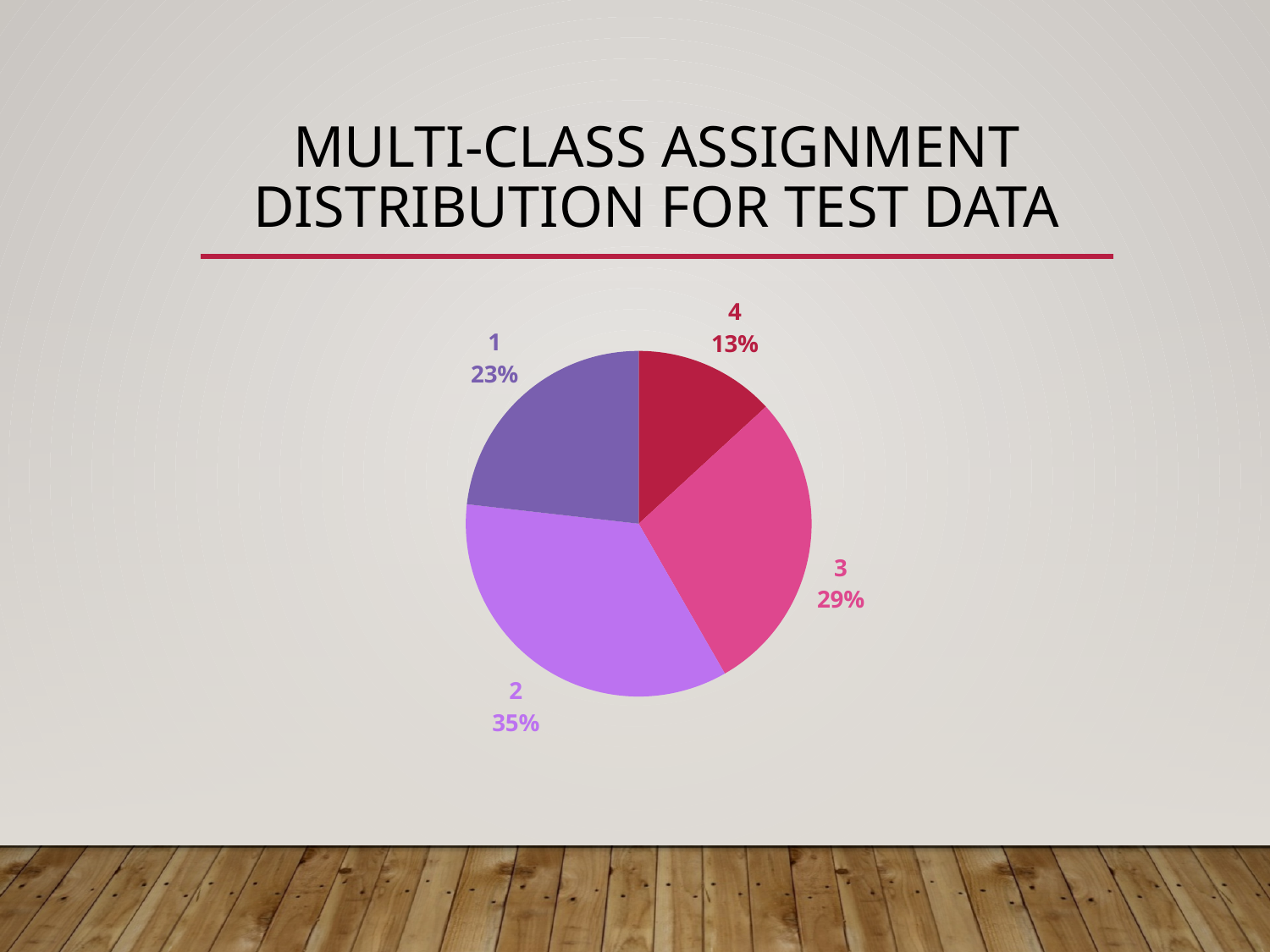
What percentage is shown for class 3? 29% Which has a larger share, class 1 or class 3? 3 What share of the pie does class 4 have? 13% What is the difference in percentage points between class 3 and class 1? 6 What percentage is shown for class 1? 23% What is the title of the slide containing the pie chart? Multi-Class Assignment Distribution for Test Data Which class has the largest slice of the pie? 2 What kind of chart is shown on the slide? pie chart What is the difference in percentage points between class 2 and class 4? 22 What share of the pie does class 2 have? 35% Which class has the smallest slice of the pie? 4 How many slices does the pie chart have? 4